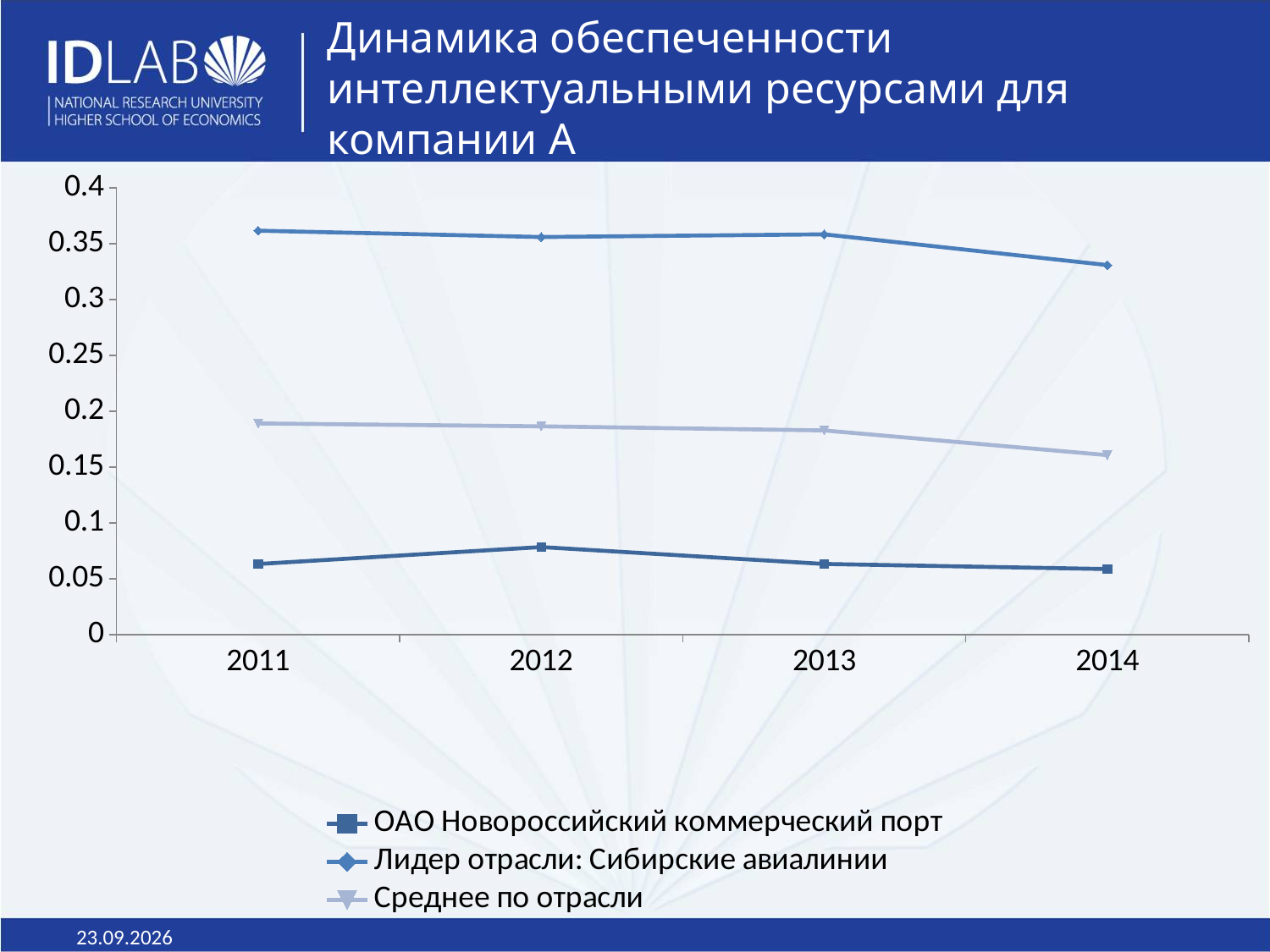
Does the value for Среднее по отрасли rise or fall from 2011 to 2014? fall Which is larger in 2013: the value for Лидер отрасли: Сибирские авиалинии or the value for ОАО Новороссийский коммерческий порт? Лидер отрасли: Сибирские авиалинии In which year does ОАО Новороссийский коммерческий порт reach its highest value? 2012 Is the value for Лидер отрасли: Сибирские авиалинии in 2014 greater or less than 0.35? less How many years are shown on the x axis? 4 What kind of chart is shown on the slide? line chart In which year is the value for Среднее по отрасли lowest? 2014 In which year is the value for Лидер отрасли: Сибирские авиалинии lowest? 2014 How many series does the legend list? 3 Which series has the highest values across all years? Лидер отрасли: Сибирские авиалинии Is the value for Среднее по отрасли in 2014 greater or less than 0.15? greater Is the value for ОАО Новороссийский коммерческий порт in 2012 greater or less than 0.1? less